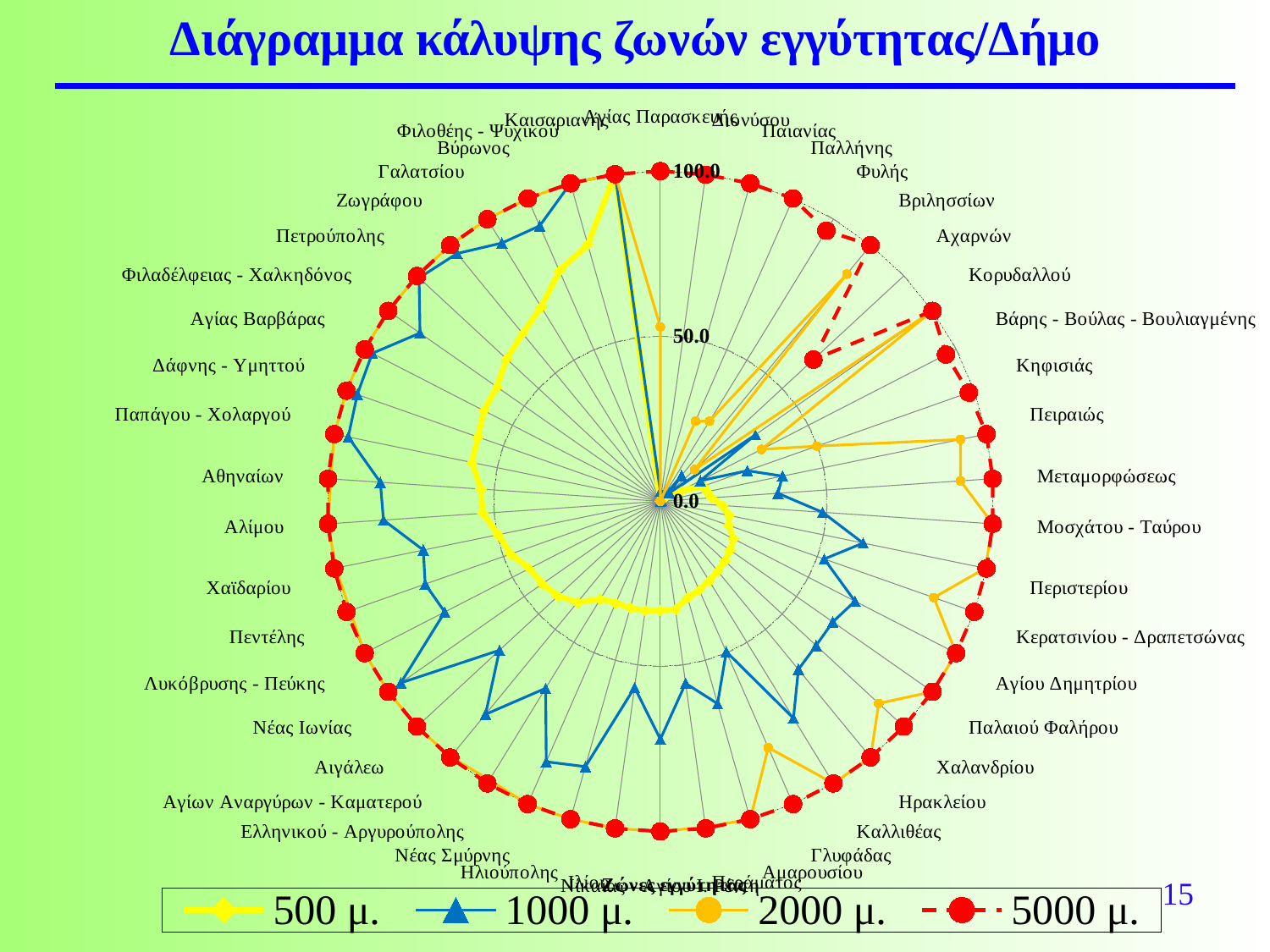
Is the value for Λυκόβρυσης - Πεύκης in the 1000 μ. series greater or less than 50? greater Is the value for Μεταμορφώσεως in the 2000 μ. series greater or less than 50? greater Is the value for Κηφισιάς in the 5000 μ. series greater or less than 50? greater What kind of chart is shown on the slide? Radar chart For Αθηναίων, which series has the larger value: 500 μ. or 1000 μ.? 1000 μ. Which series is drawn with a red dashed line? 5000 μ. How many series does the legend list? 4 What is the title of the chart? Διάγραμμα κάλυψης ζωνών εγγύτητας/Δήμο